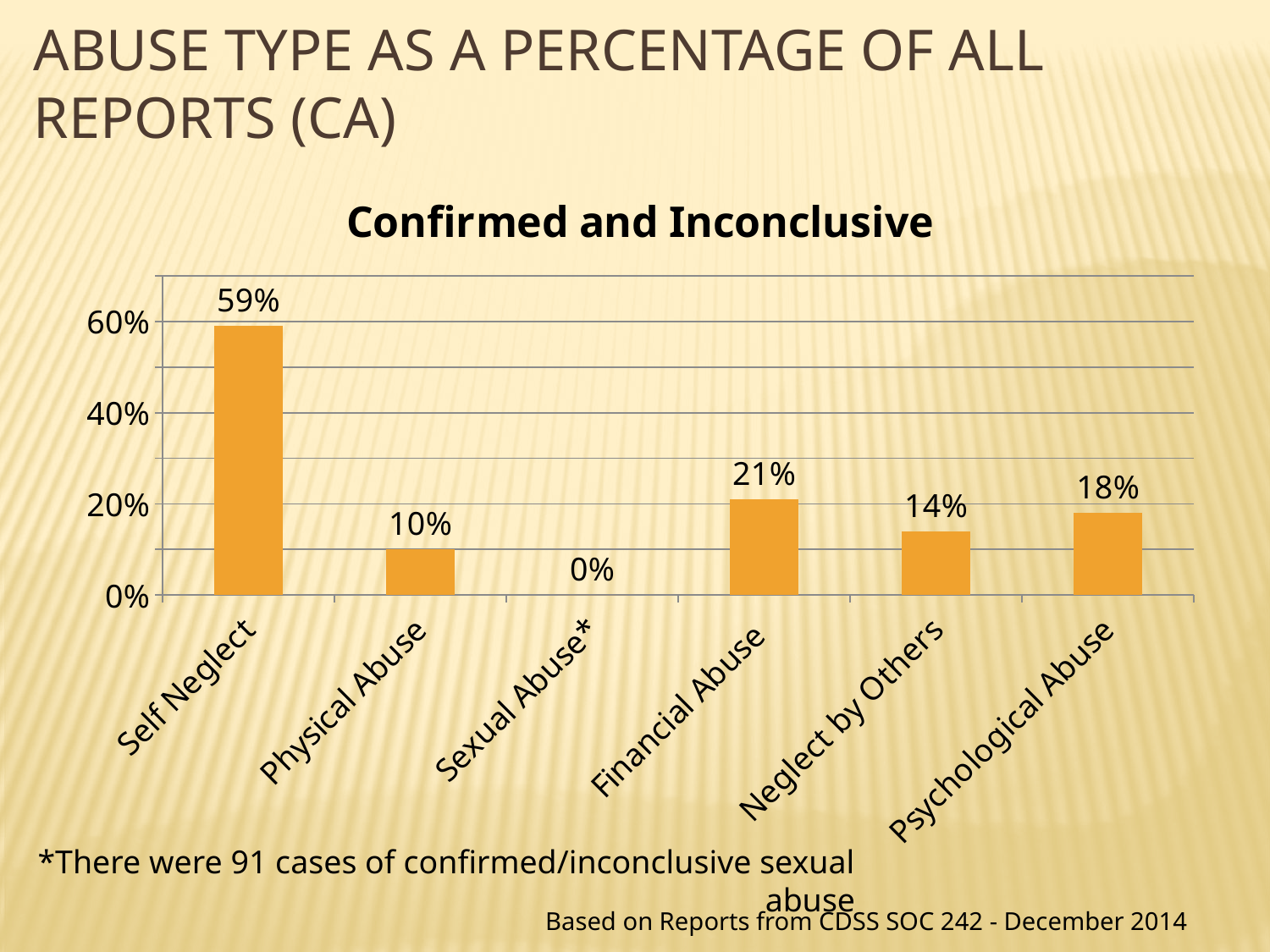
How many abuse type categories are shown on the x axis? 6 Which abuse type has the lowest percentage? Sexual Abuse* What is the value for Self Neglect? 59% What is the difference between the values for Psychological Abuse and Physical Abuse? 8% Which abuse type has the highest percentage? Self Neglect What is the title of the chart? Confirmed and Inconclusive What kind of chart is shown on the slide? Bar chart What is the value for Financial Abuse? 21% What is the difference between the values for Self Neglect and Financial Abuse? 38% What is the value for Neglect by Others? 14% What is the value for Sexual Abuse*? 0% Which is larger, the value for Financial Abuse or the value for Psychological Abuse? Financial Abuse